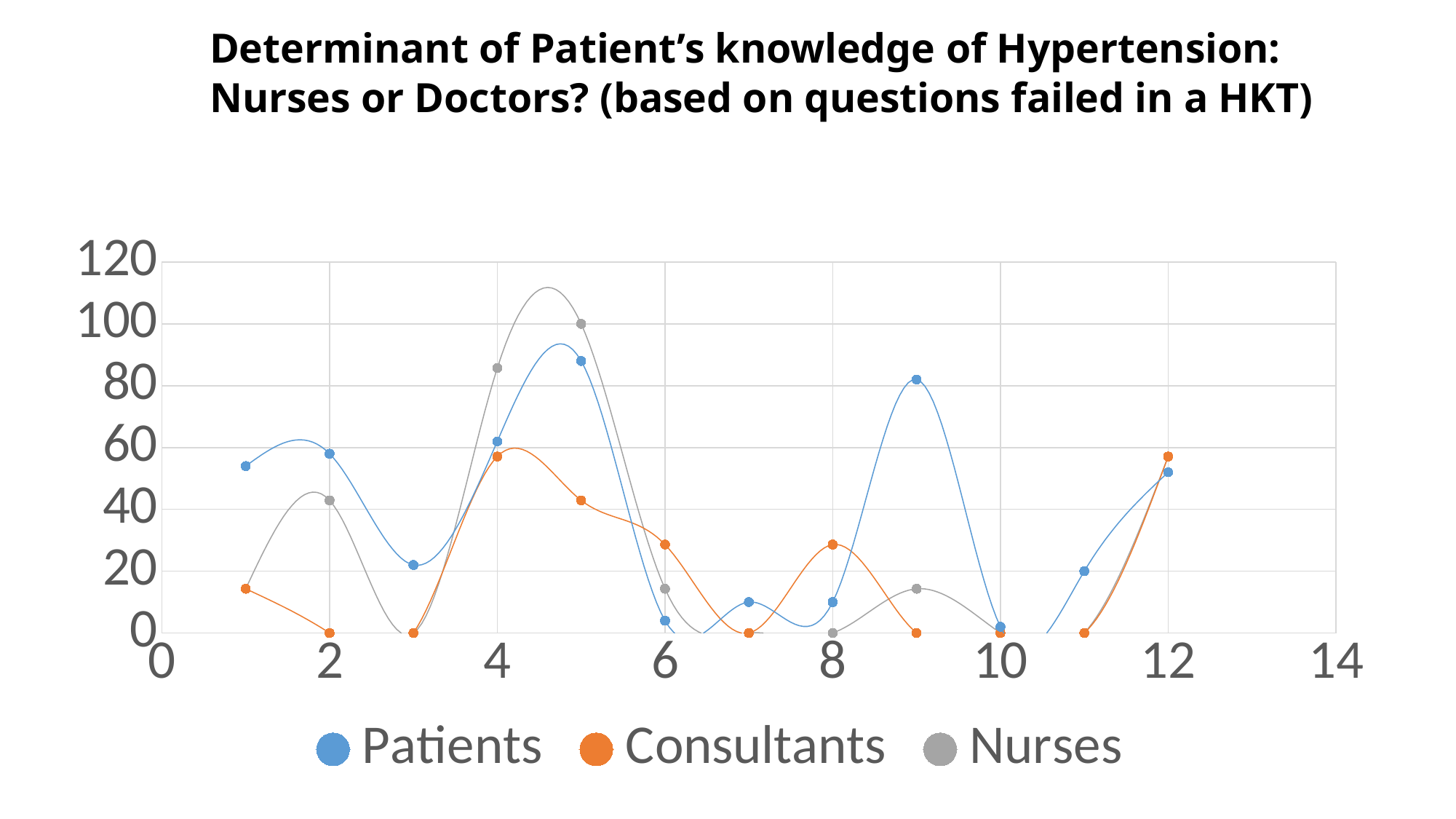
Is the Consultants value at x = 12 greater or less than 40? greater Is the Patients value at x = 3 greater or less than 40? less What is the Consultants value at x = 2? 0 At x = 4, which is larger: the Nurses value or the Patients value? Nurses What are the three series named in the legend? Patients, Consultants, Nurses At x = 5, which series has the highest value? Nurses How many data points are plotted for the Patients series? 12 At x = 8, which is larger: the Consultants value or the Patients value? Consultants How many series does the legend list? 3 Is the Patients value at x = 9 greater or less than 60? greater What is the Nurses value at x = 5? 100 What kind of chart is shown on the slide? scatter chart